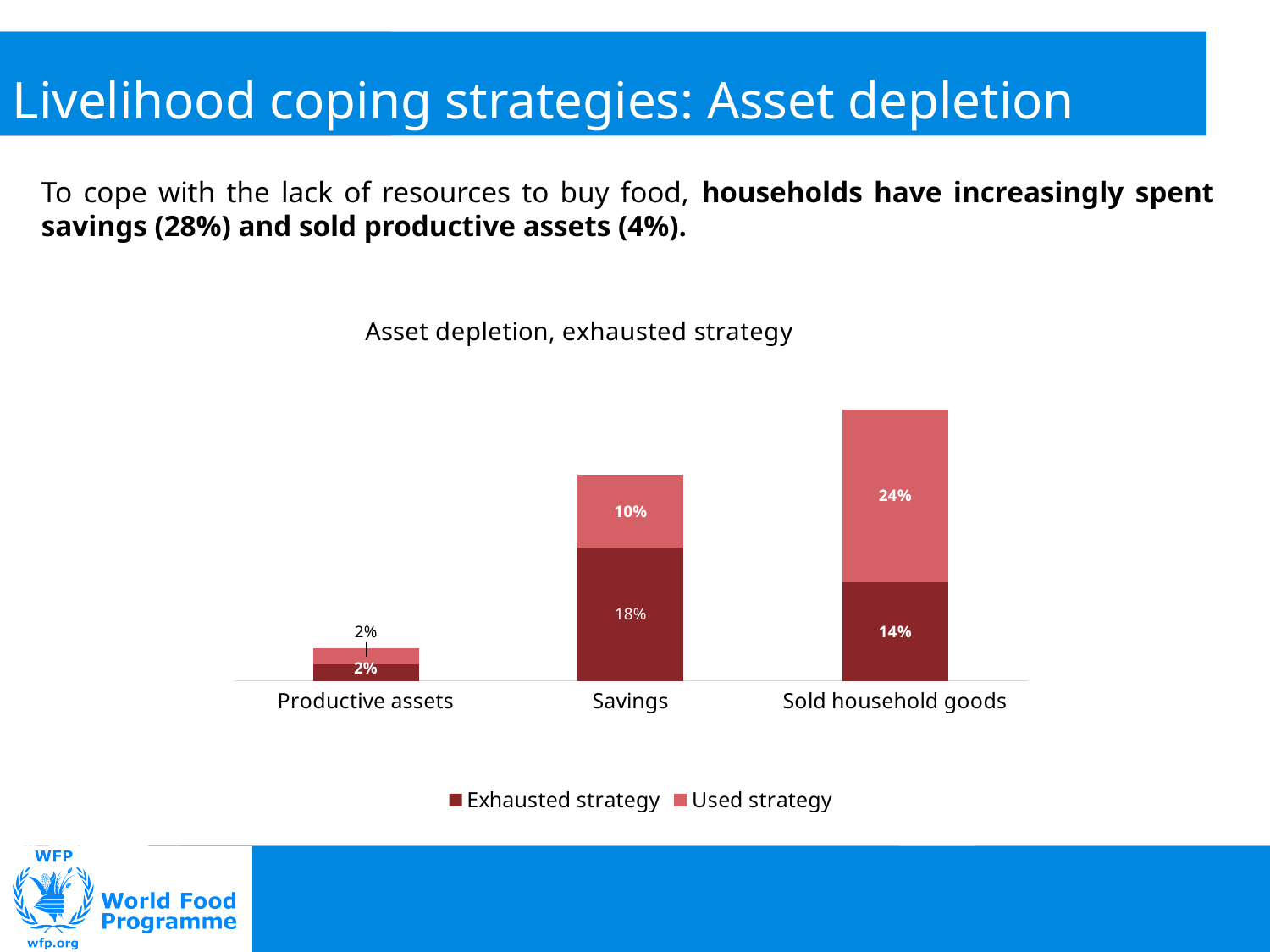
Which category has the lowest Used strategy value? Productive assets How many series does the legend list? 2 What type of chart is shown on the slide? Stacked bar chart Which category has the highest Exhausted strategy value? Savings How many categories are shown on the x axis? 3 What is the Used strategy value for Sold household goods? 24% What is the title of the chart? Asset depletion, exhausted strategy Is the Exhausted strategy value for Savings larger or smaller than the Exhausted strategy value for Sold household goods? Larger What is the Exhausted strategy value for Productive assets? 2% What is the total of the stacked bar for Sold household goods? 38% What is the Exhausted strategy value for Savings? 18% What is the difference between the Used strategy values for Sold household goods and Savings? 14%